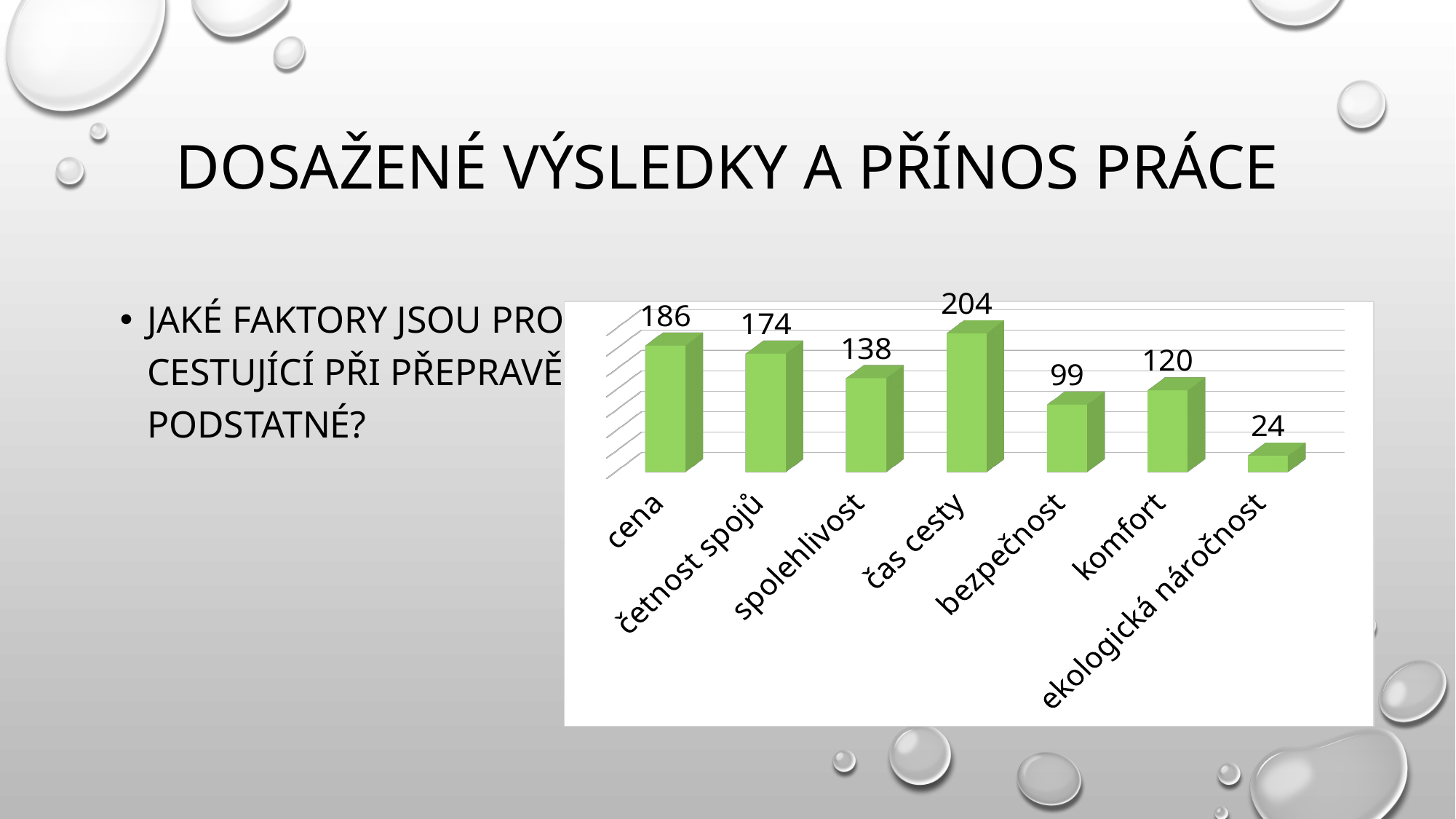
What is the value for cena? 186 How many categories are shown in the chart? 7 What is the difference between the values for čas cesty and cena? 18 What is the value for komfort? 120 What colour are the bars in the chart? green Which category has the highest value? čas cesty Which category has the lowest value? ekologická náročnost Which is larger, the value for četnost spojů or the value for spolehlivost? četnost spojů What is the value for spolehlivost? 138 What kind of chart is shown on the slide? bar chart What is the value for ekologická náročnost? 24 What is the difference between the values for komfort and bezpečnost? 21